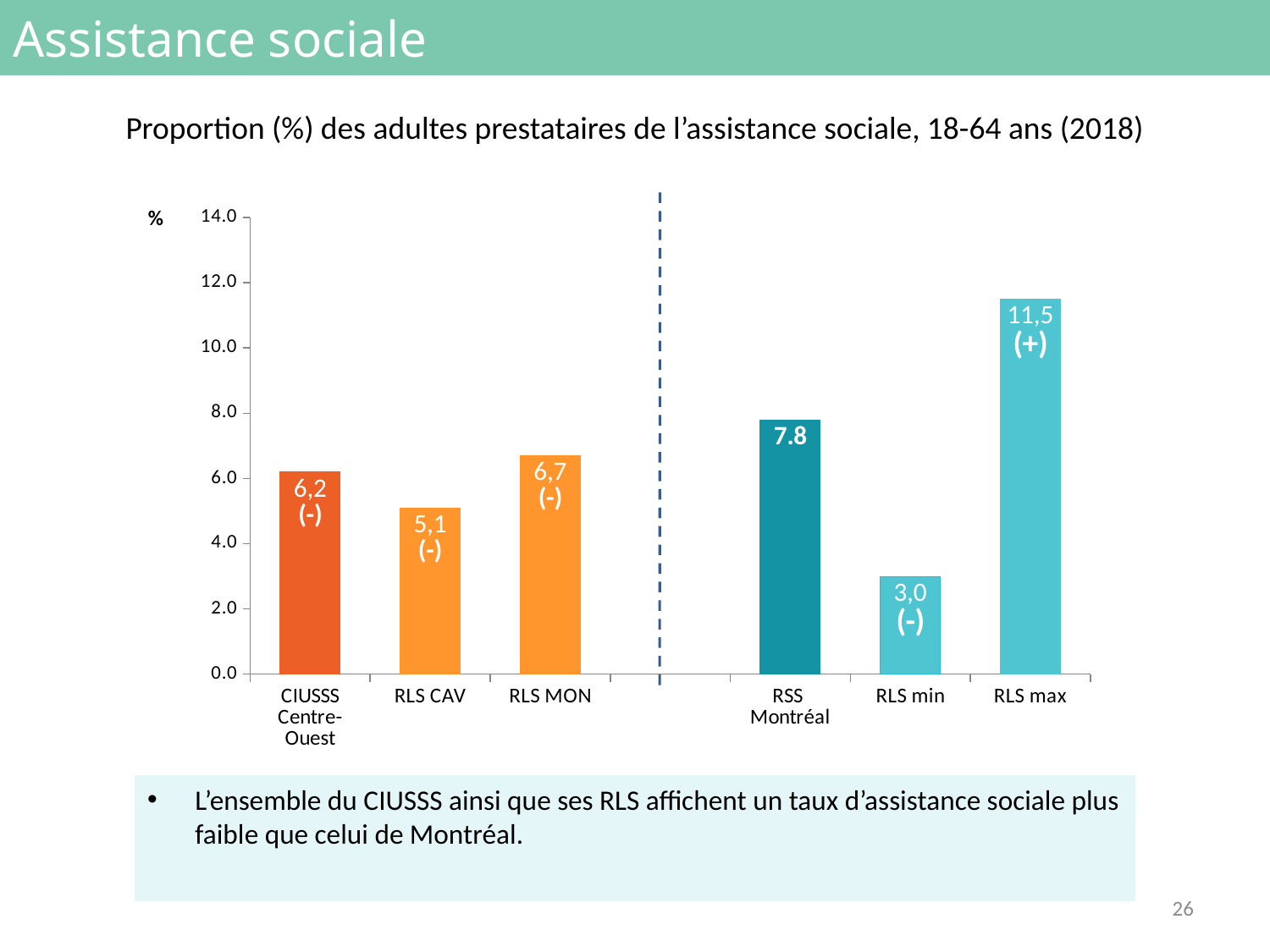
What is the value for RSS Montréal? 7.8 How many bars are shown in the chart? 6 What is the difference between the values for RLS max and RLS min? 8,5 What is the value for CIUSSS Centre-Ouest? 6,2 What kind of chart is shown on the slide? Bar chart What is the difference between the values for RLS MON and RLS CAV? 1,6 Which category has the highest value? RLS max What is the value for RLS MON? 6,7 Which is larger, the value for CIUSSS Centre-Ouest or the value for RSS Montréal? RSS Montréal What is the value for RLS min? 3,0 Which category has the lowest value? RLS min What is the value for RLS CAV? 5,1